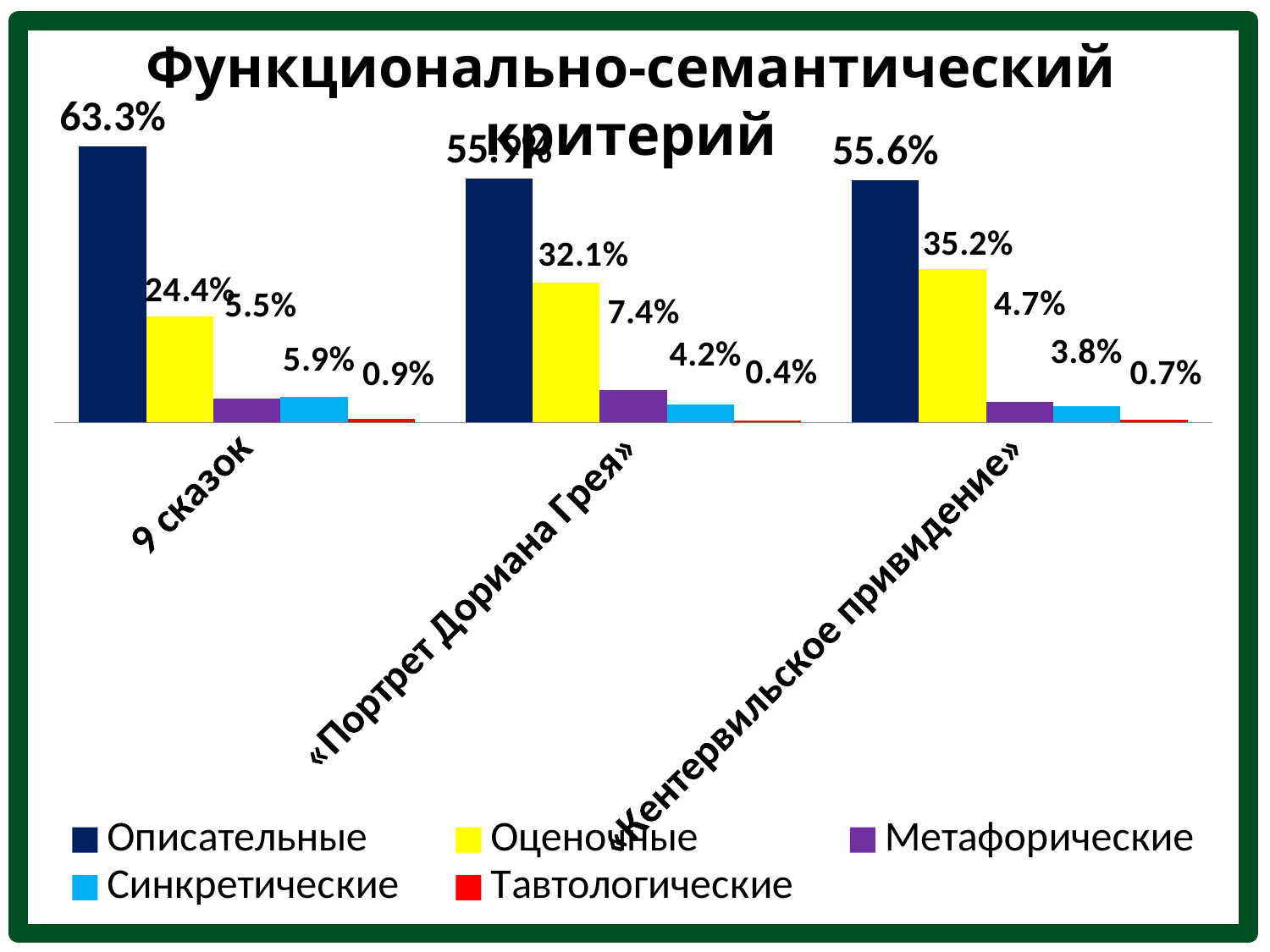
Which category has the highest value for Оценочные? «Кентервильское привидение» What is the value for Синкретические in the 9 сказок category? 5.9% Which series has the lowest value in the «Кентервильское привидение» category? Тавтологические What is the difference between the Оценочные values for «Кентервильское привидение» and 9 сказок? 10.8% Which is larger: Метафорические for 9 сказок or Синкретические for 9 сказок? Синкретические for 9 сказок What is the value for Тавтологические in the «Портрет Дориана Грея» category? 0.4% How many series does the legend list? 5 What is the value for Оценочные in the «Портрет Дориана Грея» category? 32.1% How many categories are shown on the x axis? 3 What is the value for Метафорические in the «Кентервильское привидение» category? 4.7% What kind of chart is shown on the slide? Bar chart What is the value for Описательные in the 9 сказок category? 63.3%